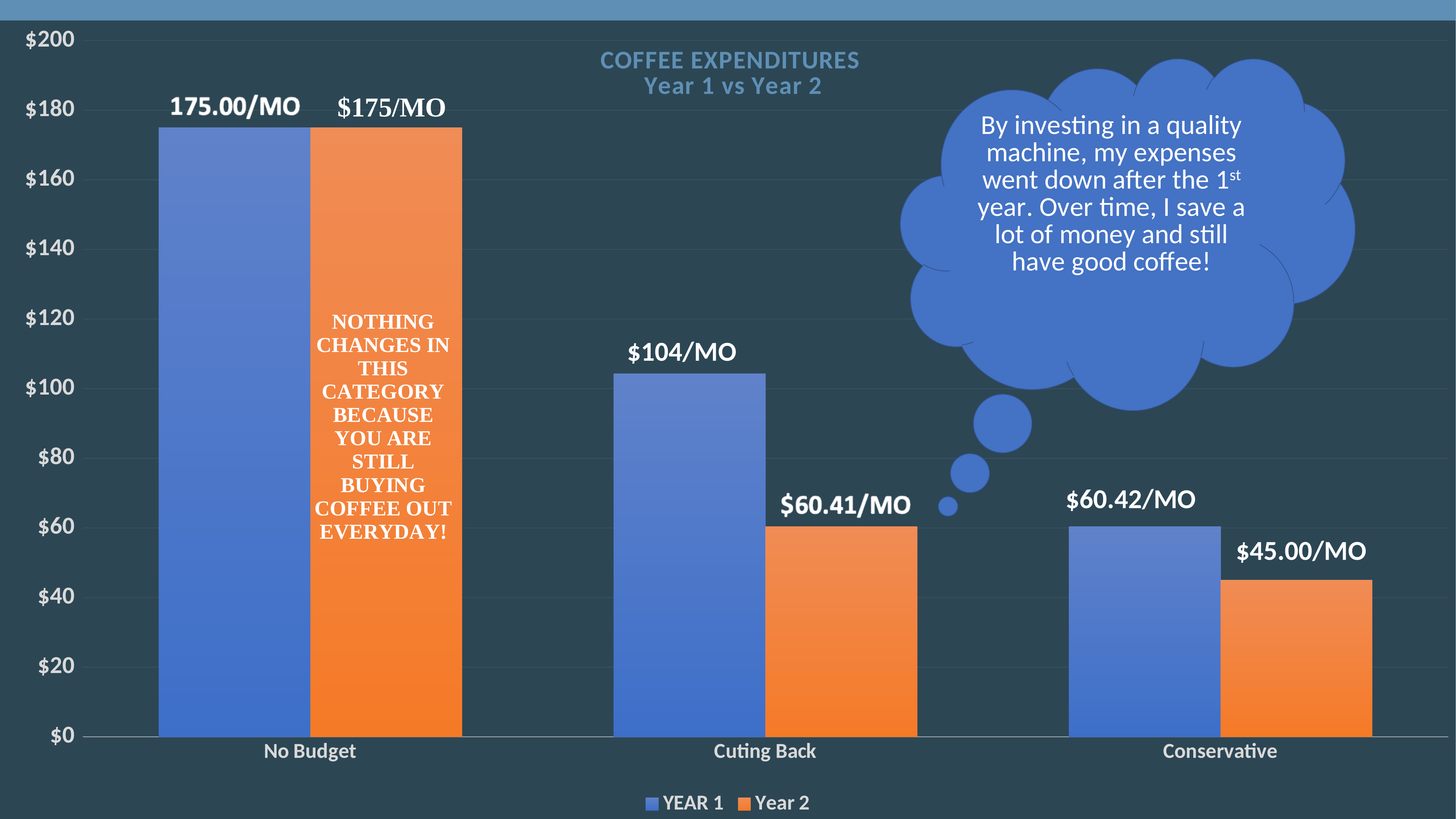
Which category has the highest YEAR 1 value? No Budget What is the Year 2 value for Conservative? $45.00/MO How many series does the legend list? 2 Which is larger, the YEAR 1 value for Cuting Back or the YEAR 1 value for Conservative? Cuting Back Which category has the lowest Year 2 value? Conservative What is the difference between the YEAR 1 values for No Budget and Cuting Back? $71 What kind of chart is shown on the slide? Bar chart What is the Year 2 value for Cuting Back? $60.41/MO What is the YEAR 1 value for Cuting Back? $104/MO What is the difference between the YEAR 1 and Year 2 values for Conservative? $15.42 How many categories are shown on the x axis? 3 What is the YEAR 1 value for Conservative? $60.42/MO